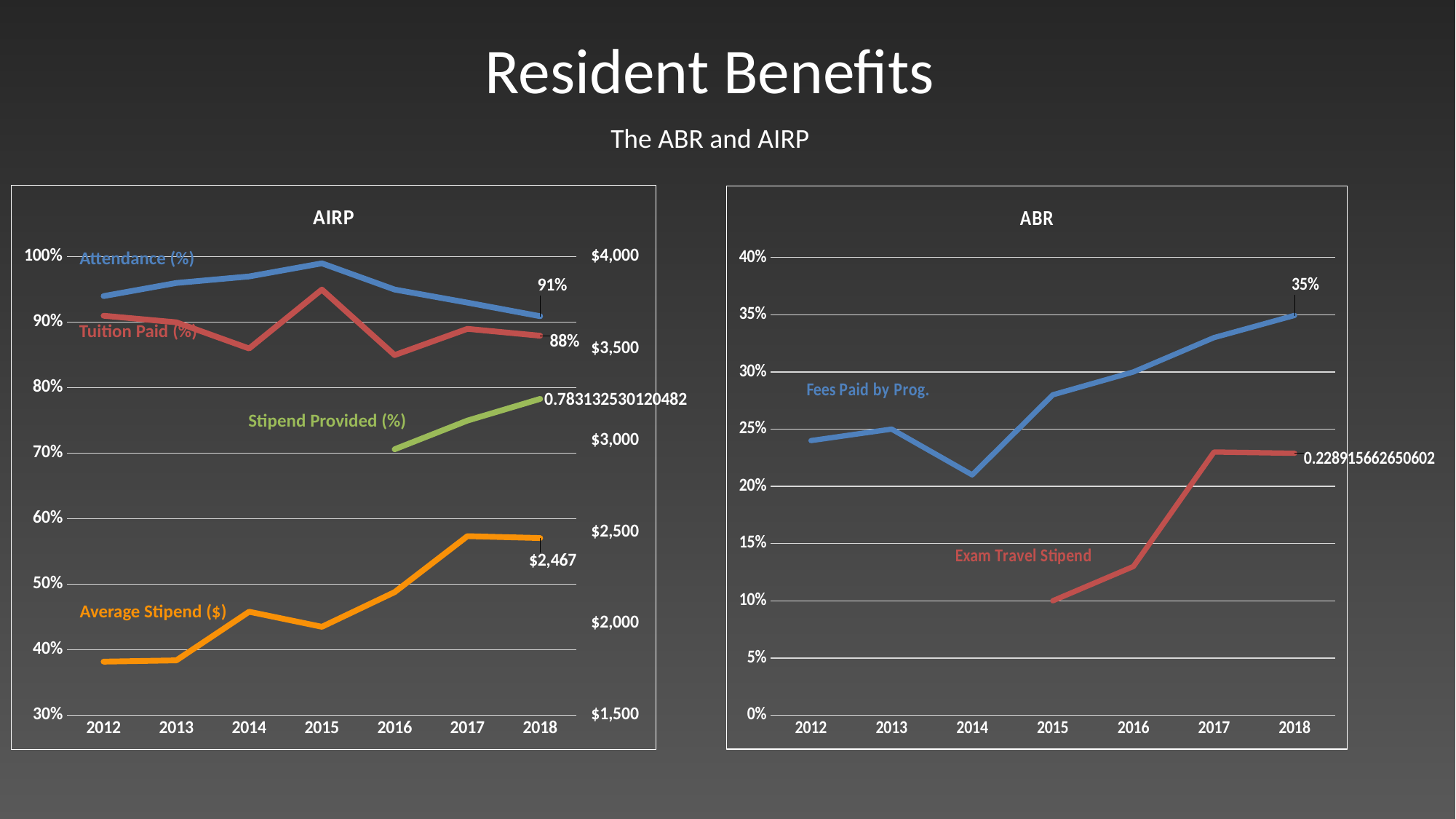
In the ABR chart, does the Exam Travel Stipend line rise or fall from 2015 to 2018? rise How many years are shown on the x axis of the ABR chart? 7 In the AIRP chart, what is the Tuition Paid (%) value for 2018? 88% In the ABR chart, what is the Fees Paid by Prog. value for 2018? 35% In the AIRP chart, what is the Average Stipend ($) value for 2018? $2,467 What kind of chart is the AIRP chart on the left? line chart In the AIRP chart, in which year is Attendance (%) highest? 2015 In the ABR chart, what data label is shown for Exam Travel Stipend in 2018? 0.228915662650602 In the ABR chart, is the Fees Paid by Prog. value for 2014 greater or less than 25%? less In the ABR chart, in which year is Fees Paid by Prog. lowest? 2014 In the AIRP chart, which is larger in 2018: Attendance (%) or Tuition Paid (%)? Attendance (%) In the AIRP chart, what is the Attendance (%) value for 2018? 91%